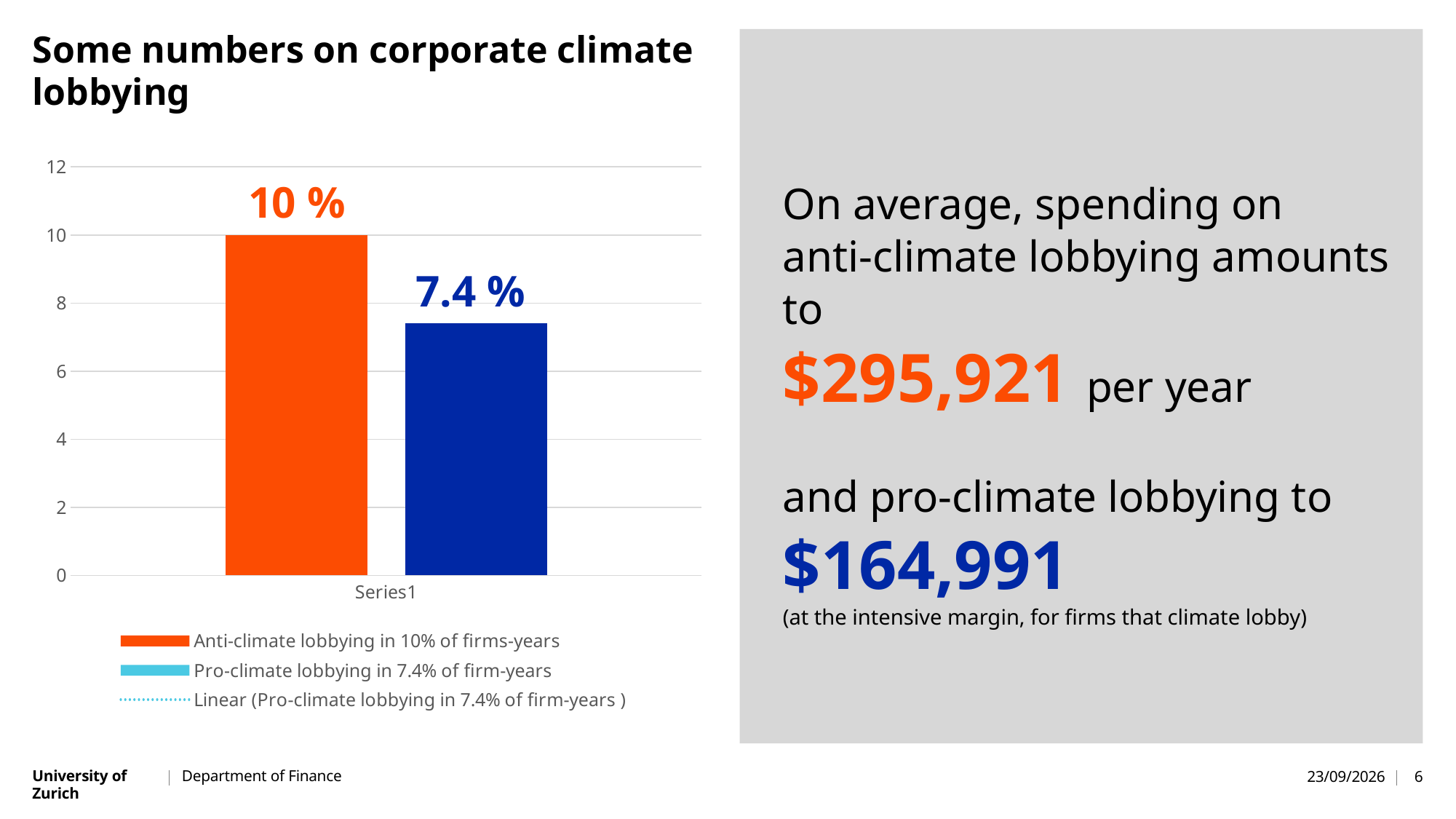
What value is labelled on the blue bar for pro-climate lobbying? 7.4 % What kind of chart is shown on the slide? bar chart What is the highest value shown on the vertical axis of the chart? 12 Is the value for pro-climate lobbying greater or less than 8? less How many entries does the chart legend list? 3 What value is labelled on the orange bar for anti-climate lobbying? 10 % Is the value for anti-climate lobbying greater or less than 8? greater Which series has the taller bar, anti-climate lobbying or pro-climate lobbying? Anti-climate lobbying How many bars are plotted in the chart? 2 What is the difference between the anti-climate lobbying value and the pro-climate lobbying value? 2.6 % What label appears on the horizontal axis beneath the bars? Series1 Which series has the shorter bar, anti-climate lobbying or pro-climate lobbying? Pro-climate lobbying